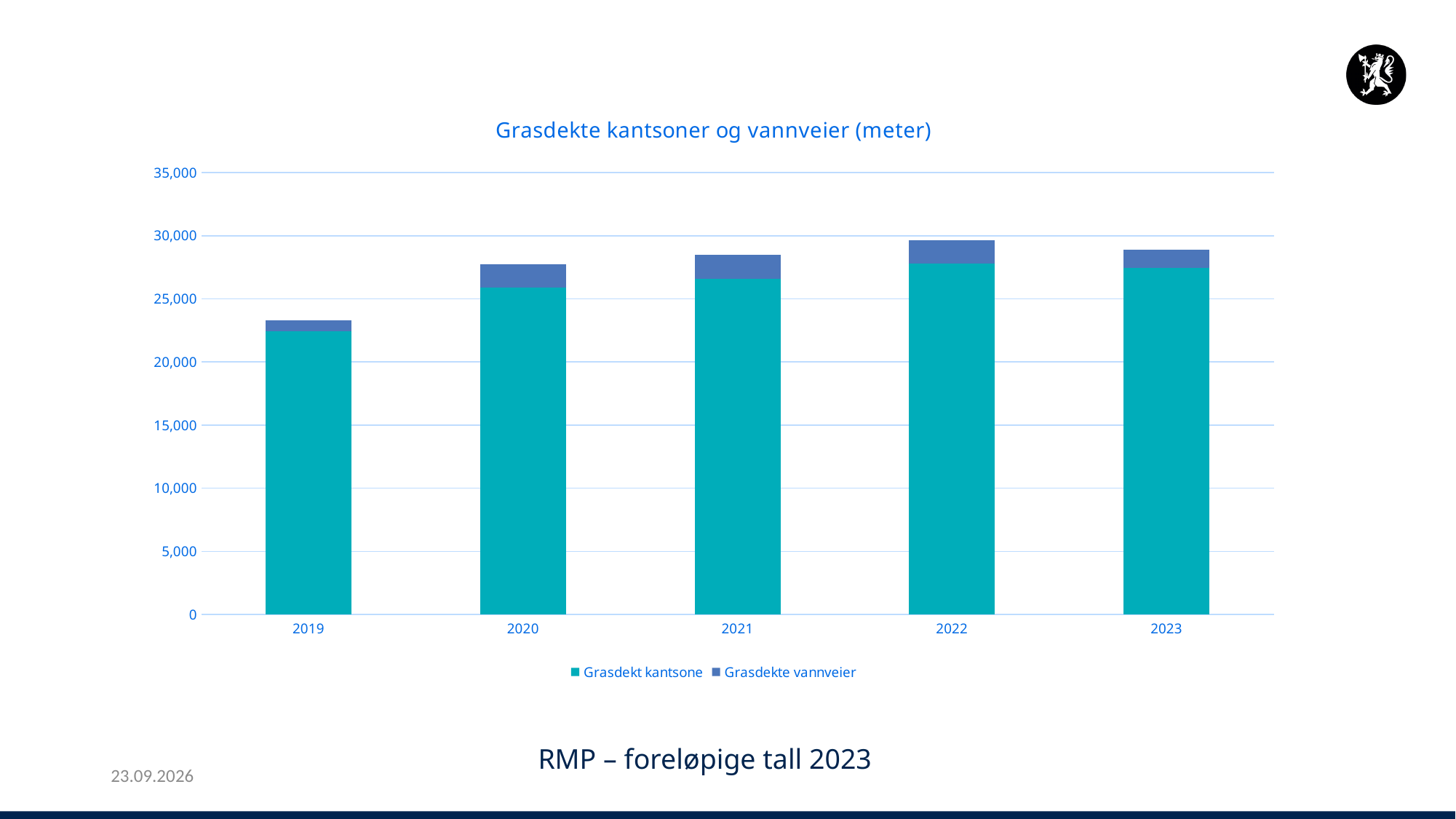
Which year has the lowest total bar? 2019 Is the total bar for 2022 greater or less than 30,000? less Do the total bars rise or fall from 2019 to 2022? rise What is the title of the chart? Grasdekte kantsoner og vannveier (meter) Which year has the highest total bar? 2022 How many years are shown on the x axis? 5 How many series does the legend list? 2 What kind of chart is shown on the slide? Stacked bar chart Which year has the larger total bar, 2019 or 2020? 2020 Is the total bar for 2019 greater or less than 25,000? less Which two series are listed in the legend? Grasdekt kantsone and Grasdekte vannveier Is the Grasdekt kantsone value for 2020 greater or less than 25,000? greater